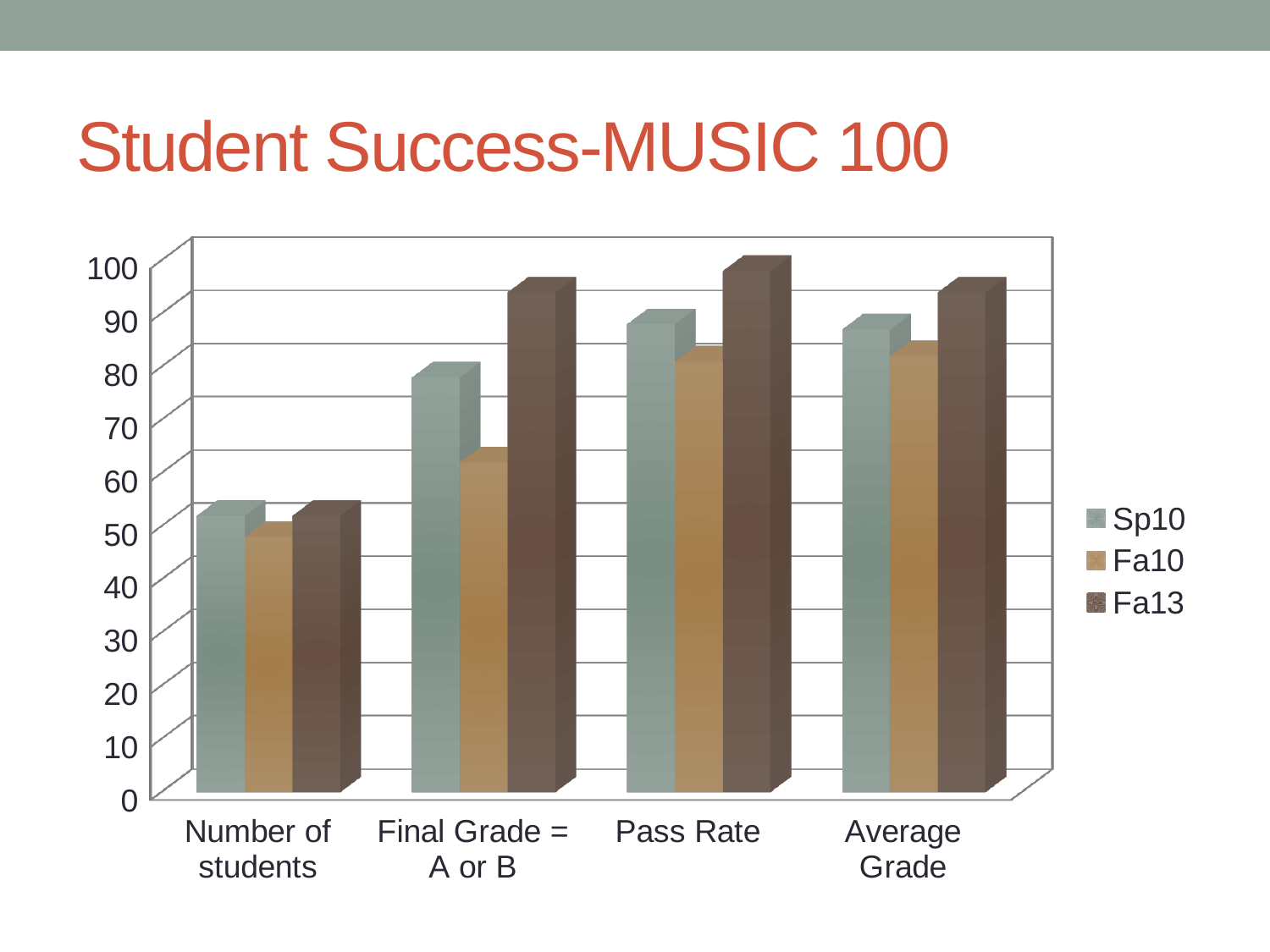
Which series are listed in the legend? Sp10, Fa10, Fa13 Is the Fa13 value for Pass Rate greater or less than 90? greater Is the Fa10 value for Pass Rate greater or less than 70? greater What kind of chart is shown on the slide? bar chart How many categories are shown on the x axis? 4 For Pass Rate, which series has the highest value? Fa13 For Final Grade = A or B, which is larger: the Sp10 value or the Fa10 value? Sp10 Is the Fa13 value for Final Grade = A or B greater or less than 90? greater What is the title of the slide containing the chart? Student Success-MUSIC 100 How many series does the legend list? 3 For Final Grade = A or B, which series has the lowest value? Fa10